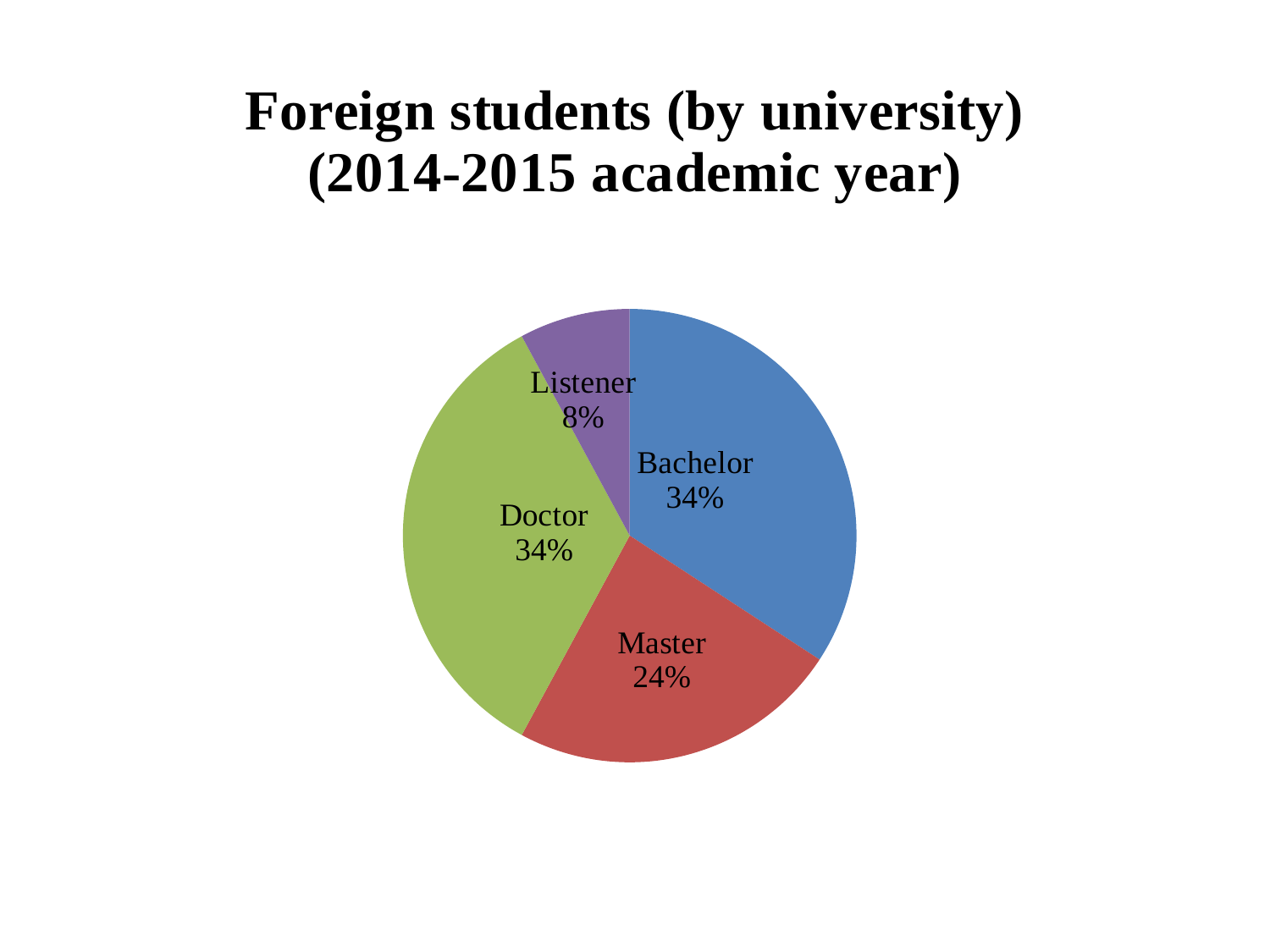
What share of foreign students are Bachelor students? 34% How many categories are shown in the pie chart? 4 What kind of chart is shown on the slide? Pie chart What share of foreign students are Doctor students? 34% What share of foreign students are Master students? 24% Which is larger, the share for Master or the share for Listener? Master Which is larger, the share for Doctor or the share for Master? Doctor What is the title of the slide containing the pie chart? Foreign students (by university) (2014-2015 academic year) Which category has the smallest share of the pie? Listener What is the difference in percentage points between the Master share and the Listener share? 16 What is the difference in percentage points between the Bachelor share and the Master share? 10